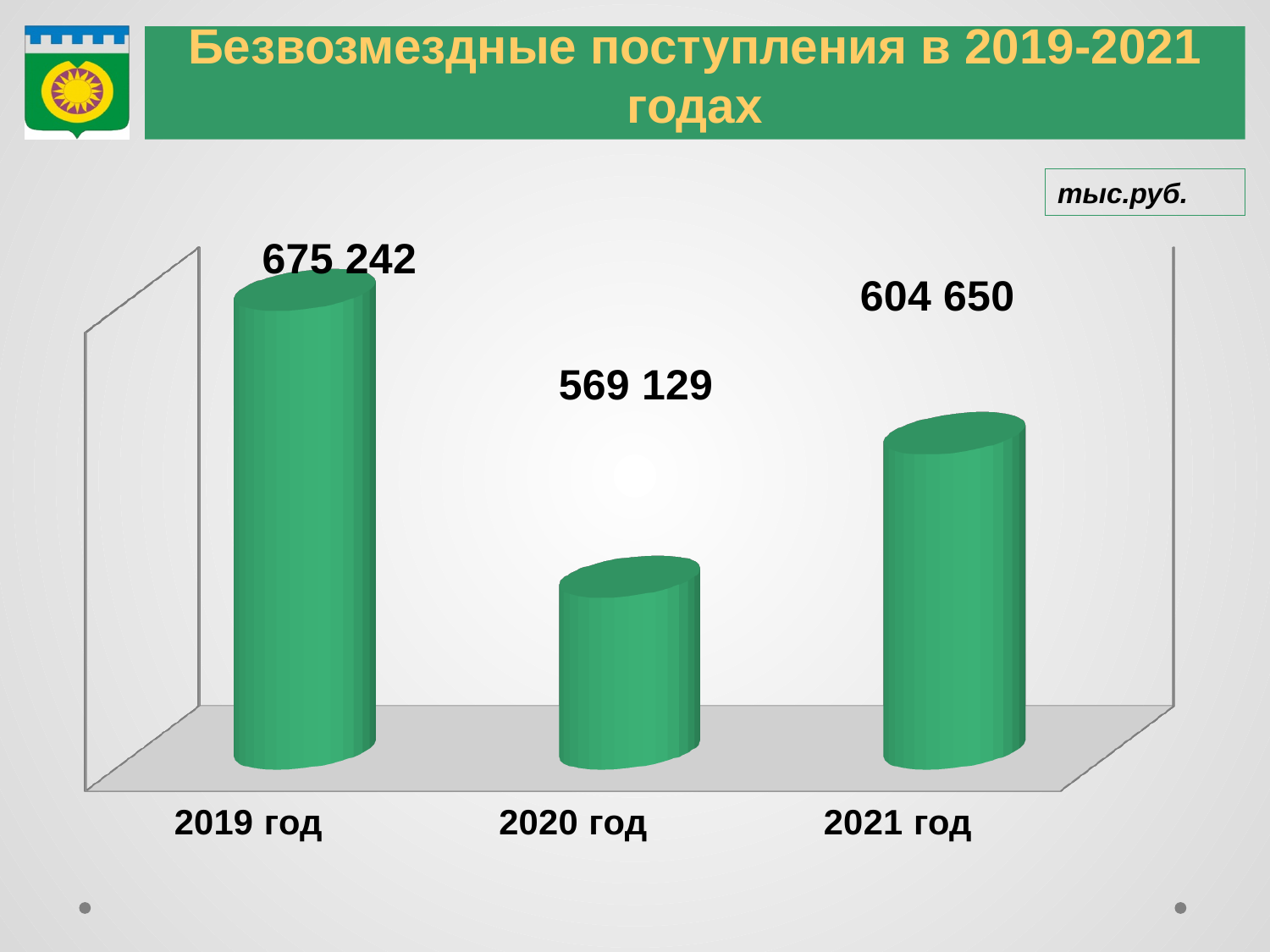
Which year has the lowest value? 2020 год What is the difference between the values for 2019 год and 2020 год? 106 113 What is the title of the chart? Безвозмездные поступления в 2019-2021 годах What kind of chart is shown on the slide? bar chart What is the difference between the values for 2021 год and 2020 год? 35 521 What is the value for 2019 год? 675 242 What is the value for 2021 год? 604 650 Which is larger, the value for 2019 год or the value for 2021 год? 2019 год How many years are shown on the chart? 3 What is the value for 2020 год? 569 129 Which year has the highest value? 2019 год In what units are the values on the chart given? тыс.руб.